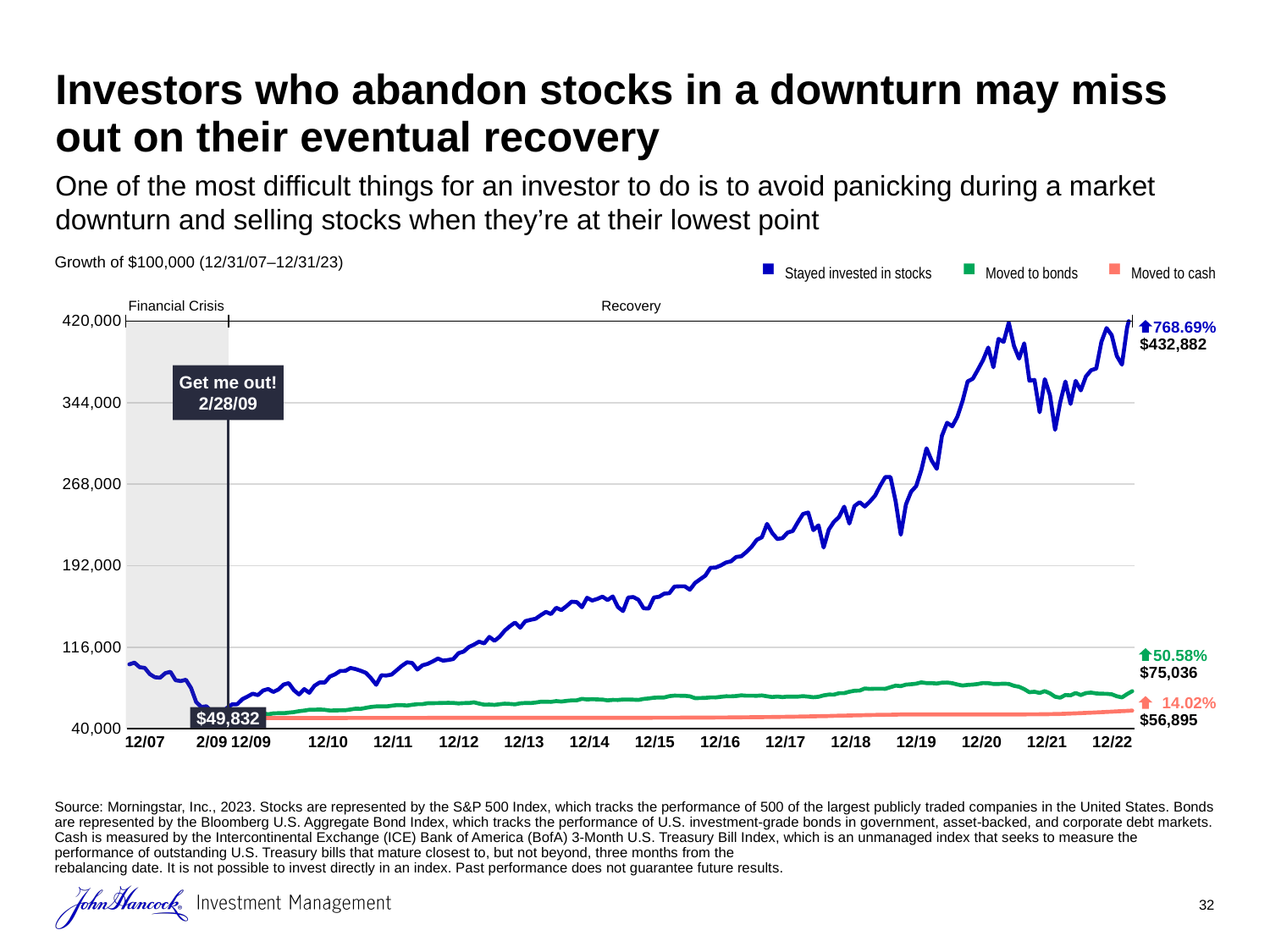
Which series has the highest ending value? Stayed invested in stocks How many series does the legend list? 3 What kind of chart is shown on the slide? Line chart What is the ending value of the 'Moved to bonds' line? $75,036 What is the ending value of the 'Stayed invested in stocks' line? $432,882 What percentage gain is shown for the 'Moved to cash' line? 14.02% What is the ending value of the 'Moved to cash' line? $56,895 Which has a larger ending value, 'Moved to bonds' or 'Moved to cash'? Moved to bonds What is the difference between the ending values of 'Stayed invested in stocks' and 'Moved to bonds'? $357,846 What percentage gain is shown for the 'Stayed invested in stocks' line? 768.69% What value is labeled on the chart at the 'Get me out!' date of 2/28/09? $49,832 Which series has the lowest ending value? Moved to cash